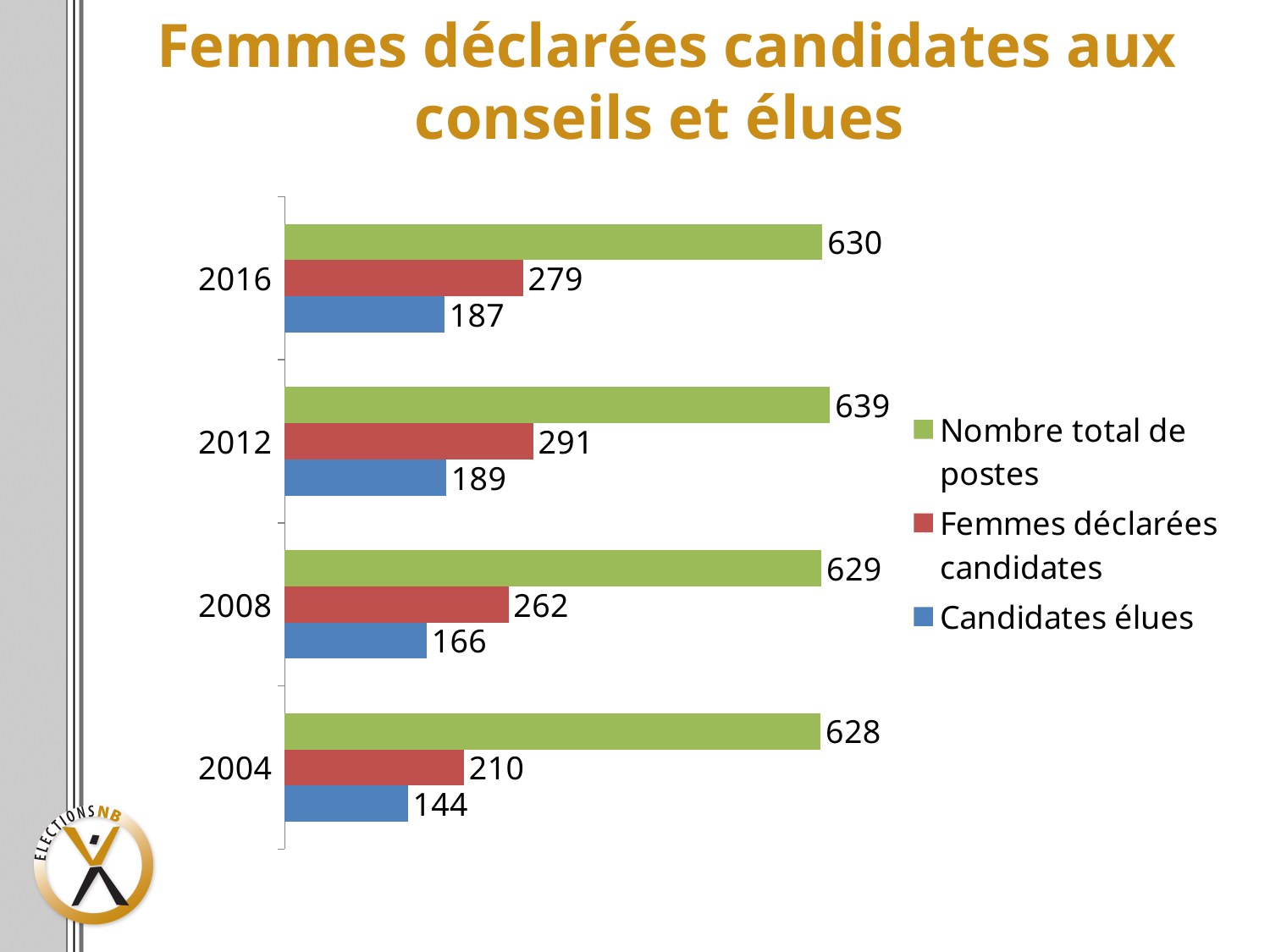
What is the title of the slide? Femmes déclarées candidates aux conseils et élues How many series does the legend list? 3 What is the value for Femmes déclarées candidates in 2012? 291 Which year has the lowest value for Femmes déclarées candidates? 2004 What kind of chart is shown on the slide? Bar chart What is the value for Candidates élues in 2004? 144 Which series is shown in green in the legend? Nombre total de postes How many years are shown on the chart? 4 What is the difference between Femmes déclarées candidates and Candidates élues in 2016? 92 Which is larger: Femmes déclarées candidates in 2008 or in 2016? 2016 Which year has the highest value for Candidates élues? 2012 What is the value for Nombre total de postes in 2008? 629